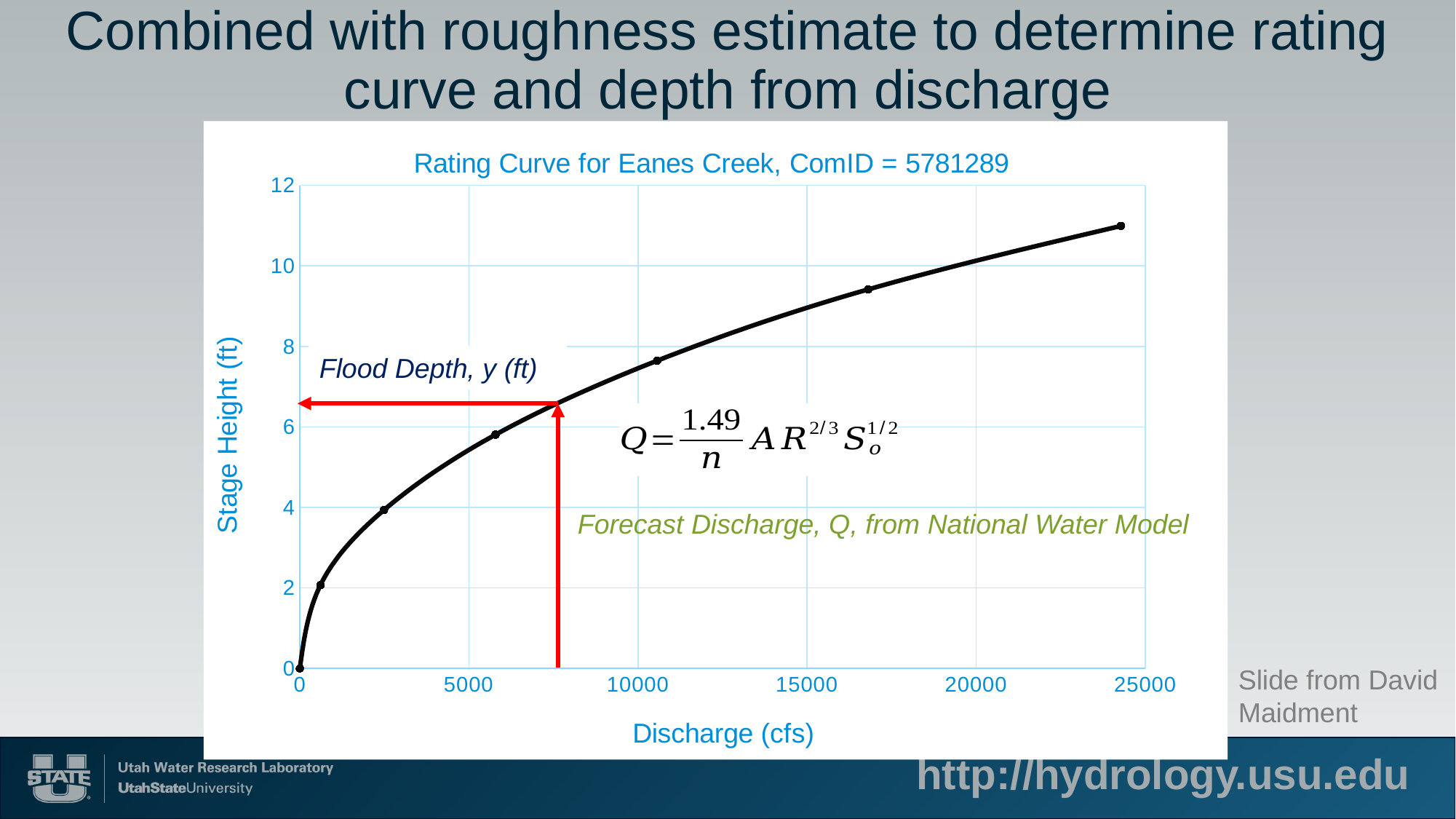
Is the stage height at the highest plotted discharge (near 25000 cfs) greater or less than 10 ft? greater Does the stage height rise or fall as discharge increases along the x axis? rise What is the label of the y axis? Stage Height (ft) How many data points are marked on the rating curve? 7 What kind of chart is shown on the slide? line chart What is the title of the chart? Rating Curve for Eanes Creek, ComID = 5781289 Is the stage height at a discharge of 5000 cfs greater or less than 6 ft? less Is the forecast discharge indicated by the red vertical arrow greater or less than 10000 cfs? less What is the highest value labelled on the x axis? 25000